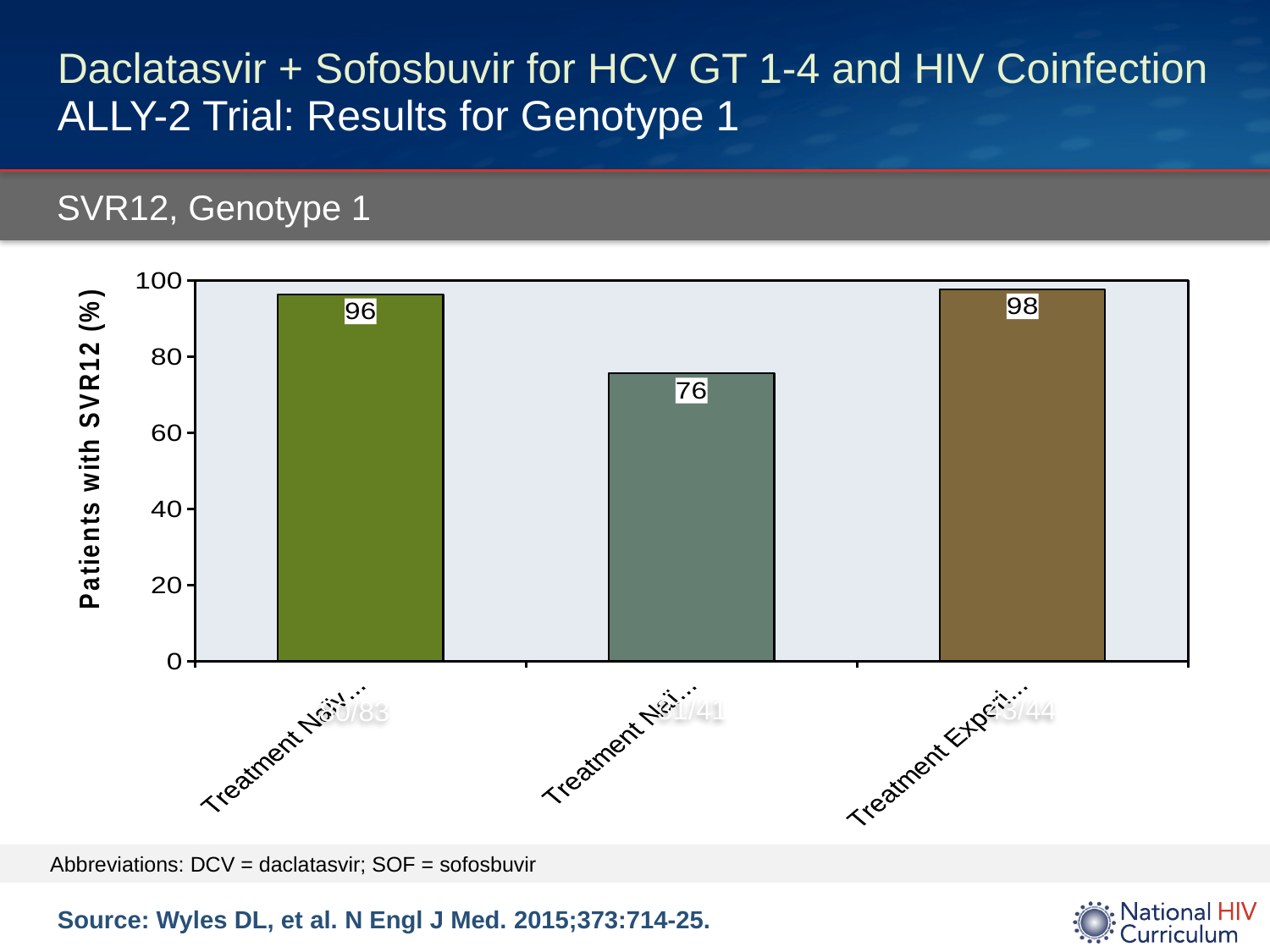
What is the difference between the right bar and the middle bar? 22 Which bar has the lowest value? The middle bar (76) What is the value of the left bar in the chart? 96 Which bar has the highest value? The right bar (98) Is the value of the middle bar greater or less than 80? less Which is larger, the left bar or the middle bar? The left bar What is the value of the right bar in the chart? 98 What kind of chart is shown on the slide? Bar chart How many bars are shown in the chart? 3 What is the value of the middle bar in the chart? 76 What is the difference between the left bar and the middle bar? 20 What is the label of the vertical axis? Patients with SVR12 (%)